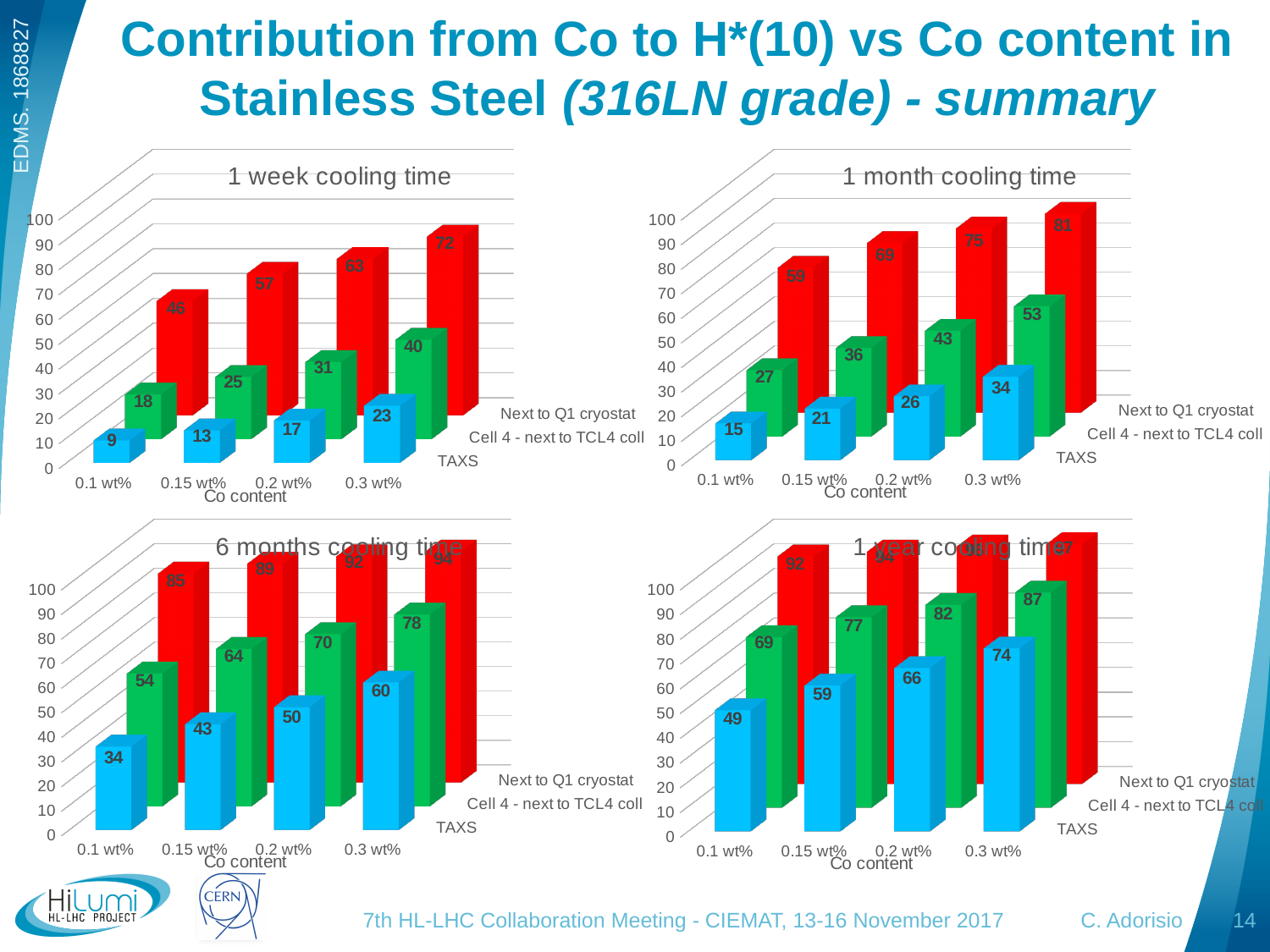
How many Co content categories are shown on the x axis of the '1 month cooling time' chart? 4 In the '6 months cooling time' chart, what is the value for 'Cell 4 - next to TCL4 coll' at 0.2 wt%? 70 In the '1 week cooling time' chart, how do the TAXS values change as Co content increases from 0.1 wt% to 0.3 wt%? They rise In the '6 months cooling time' chart, what is the difference between the 'Next to Q1 cryostat' value and the TAXS value at 0.1 wt%? 51 How many series are plotted in the '6 months cooling time' chart? 3 In the '1 year cooling time' chart, which is larger: 'Cell 4 - next to TCL4 coll' at 0.3 wt% or TAXS at 0.3 wt%? Cell 4 - next to TCL4 coll In the '1 week cooling time' chart, what is the value for TAXS at 0.3 wt%? 23 In the '1 year cooling time' chart, what is the value for TAXS at 0.1 wt%? 49 In the '1 month cooling time' chart, what is the value for 'Next to Q1 cryostat' at 0.15 wt%? 69 In the '1 week cooling time' chart, which Co content has the highest value for 'Next to Q1 cryostat'? 0.3 wt% In the '1 month cooling time' chart, which Co content has the lowest value for TAXS? 0.1 wt% What kind of chart is the '1 year cooling time' chart? Bar chart